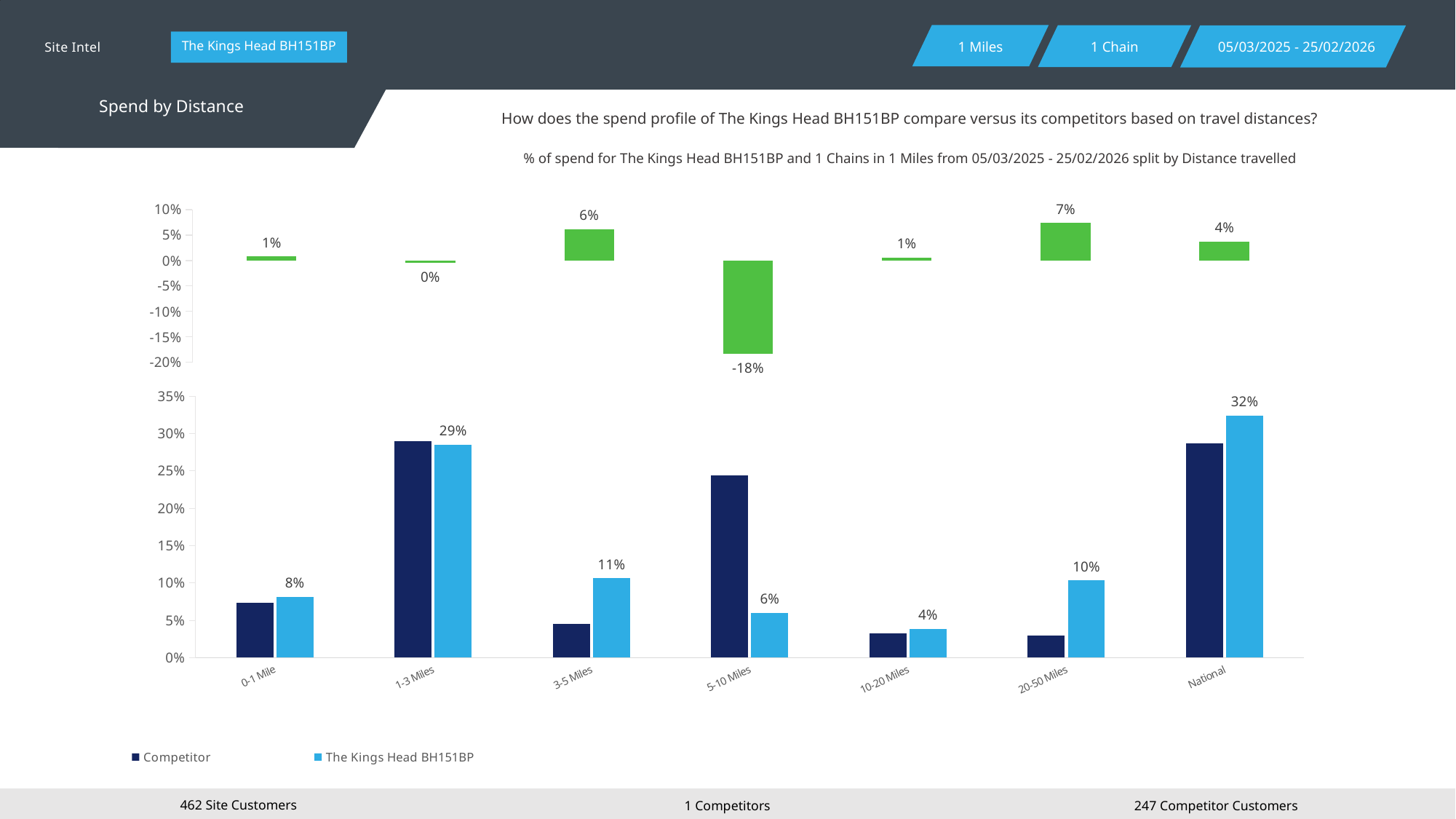
How many distance bands are shown on the x axis of the bottom chart? 7 In the top chart, what is the lowest value shown? -18% In the bottom chart, which distance band has the highest value for The Kings Head BH151BP? National In the bottom chart, what is the value for The Kings Head BH151BP at 0-1 Mile? 8% How many series does the legend of the bottom chart list? 2 In the bottom chart, what is the value for The Kings Head BH151BP at National? 32% In the bottom chart, which distance band has the lowest value for The Kings Head BH151BP? 10-20 Miles What kind of chart is the bottom chart? bar chart In the bottom chart, at 5-10 Miles, which series has the larger value: Competitor or The Kings Head BH151BP? Competitor In the bottom chart, is the Competitor value for 1-3 Miles greater or less than 25%? greater In the bottom chart, is the Competitor value for 20-50 Miles greater or less than 5%? less In the bottom chart, what is the difference between The Kings Head BH151BP values for National and 1-3 Miles? 3%